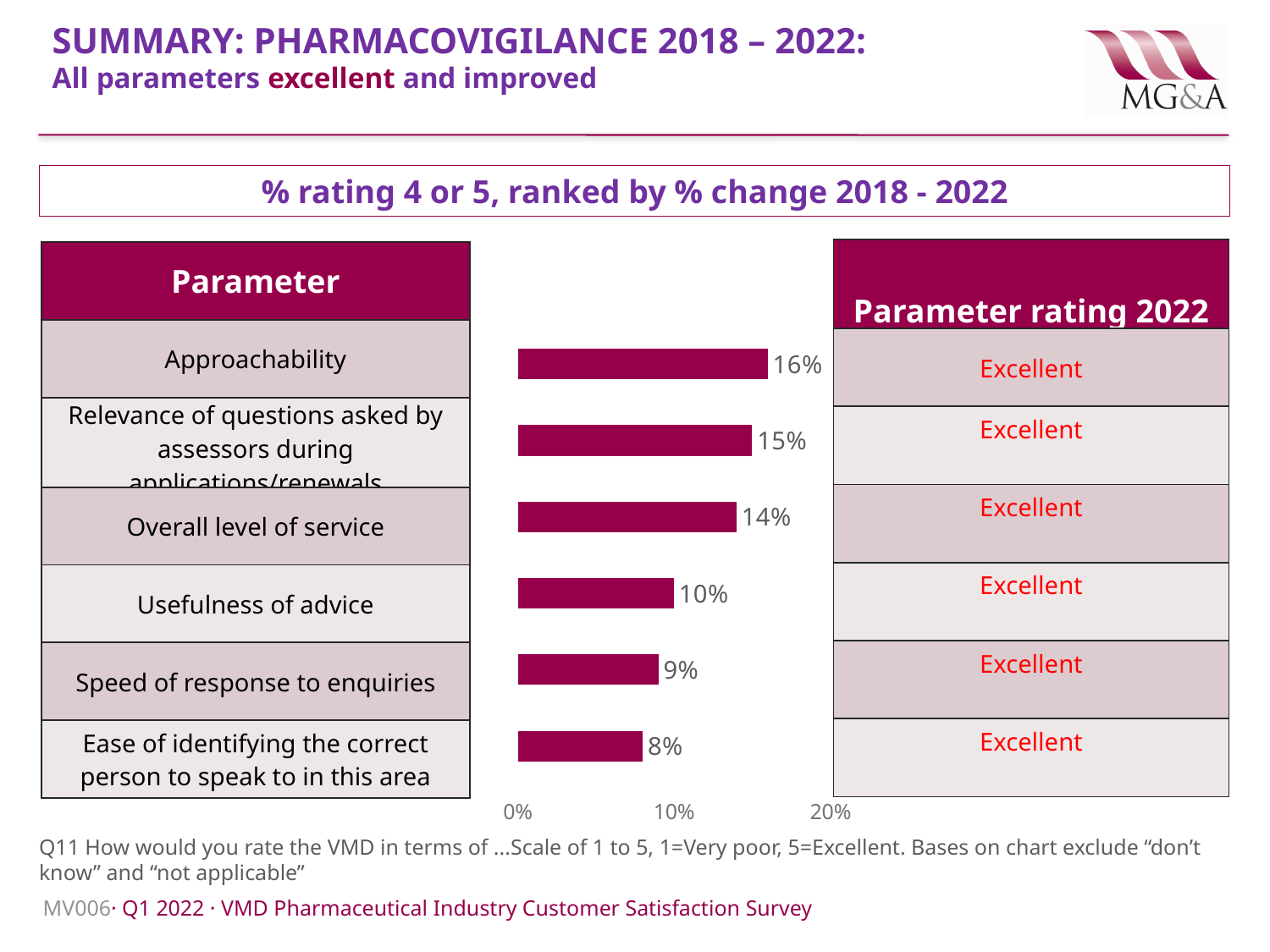
What kind of chart is shown on the slide? bar chart How many parameters are shown in the chart? 6 Which parameter has the lowest % change? Ease of identifying the correct person to speak to in this area What is the % change for Approachability? 16% What is the % change for Speed of response to enquiries? 9% What is the % change for Ease of identifying the correct person to speak to in this area? 8% What is the difference between the % change for Approachability and Usefulness of advice? 6% What is the % change for Overall level of service? 14% Is the value for Usefulness of advice greater or less than 20%? less What is the title of the chart? % rating 4 or 5, ranked by % change 2018 - 2022 Which parameter has the highest % change? Approachability Which has a larger % change, Overall level of service or Speed of response to enquiries? Overall level of service